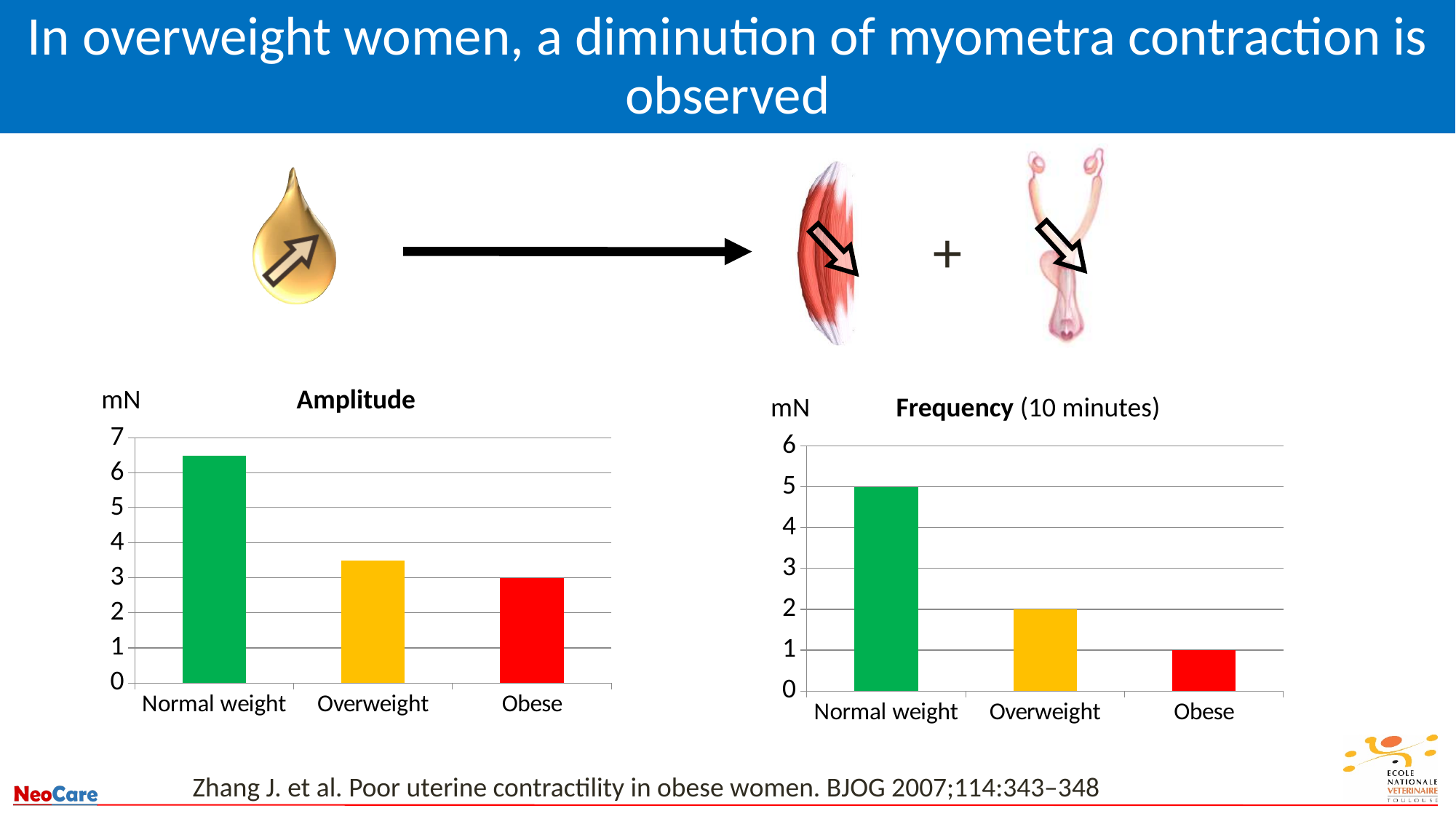
In the Frequency (10 minutes) chart, what colour is the Overweight bar? yellow How many categories are shown in the Amplitude chart? 3 In the Frequency (10 minutes) chart, what is the value for Normal weight? 5 In the Amplitude chart, what is the value for Obese? 3 In the Frequency (10 minutes) chart, what is the difference between Normal weight and Overweight? 3 In the Amplitude chart, which category has the highest value? Normal weight In the Amplitude chart, is the value for Normal weight greater or less than 6? greater In the Amplitude chart, is the value for Overweight greater or less than 4? less In the Amplitude chart, which category has the lowest value? Obese In the Frequency (10 minutes) chart, what is the value for Obese? 1 In the Frequency (10 minutes) chart, do the values rise or fall from Normal weight to Obese? fall What kind of chart is the Amplitude chart? bar chart